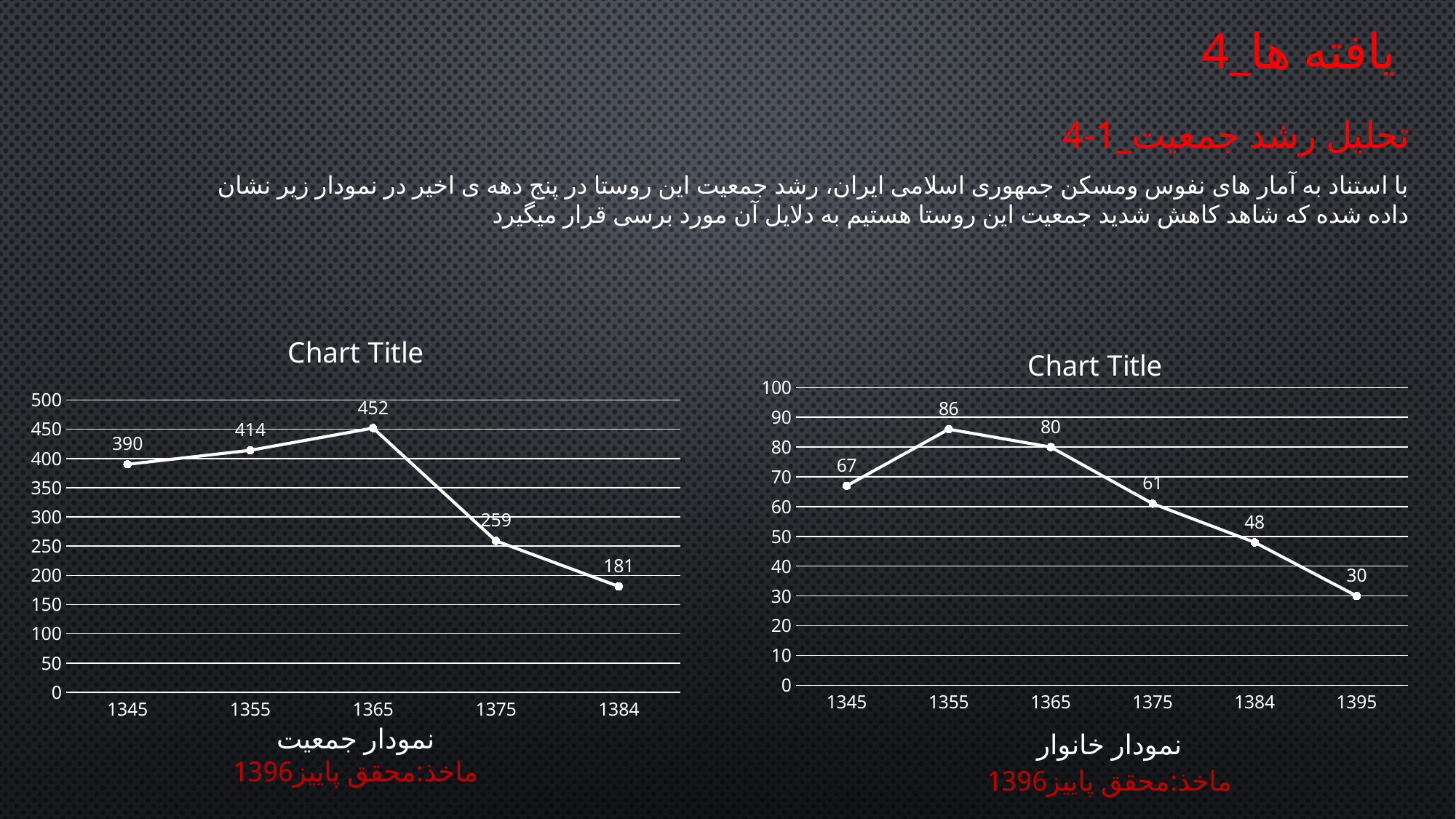
What kind of chart is the left chart? line chart On the left chart, what is the difference between the values for 1365 and 1375? 193 On the left chart, what is the value for 1365? 452 On the right chart, which is larger, the value for 1365 or the value for 1375? 1365 On the right chart, what is the value for 1355? 86 On the left chart, do the values rise or fall from 1365 to 1384? fall On the right chart, what is the difference between the values for 1345 and 1355? 19 On the left chart, what is the value for 1384? 181 On the left chart, which year has the highest value? 1365 On the right chart, what is the value for 1395? 30 How many data points are plotted on the right chart? 6 On the right chart, which year has the lowest value? 1395